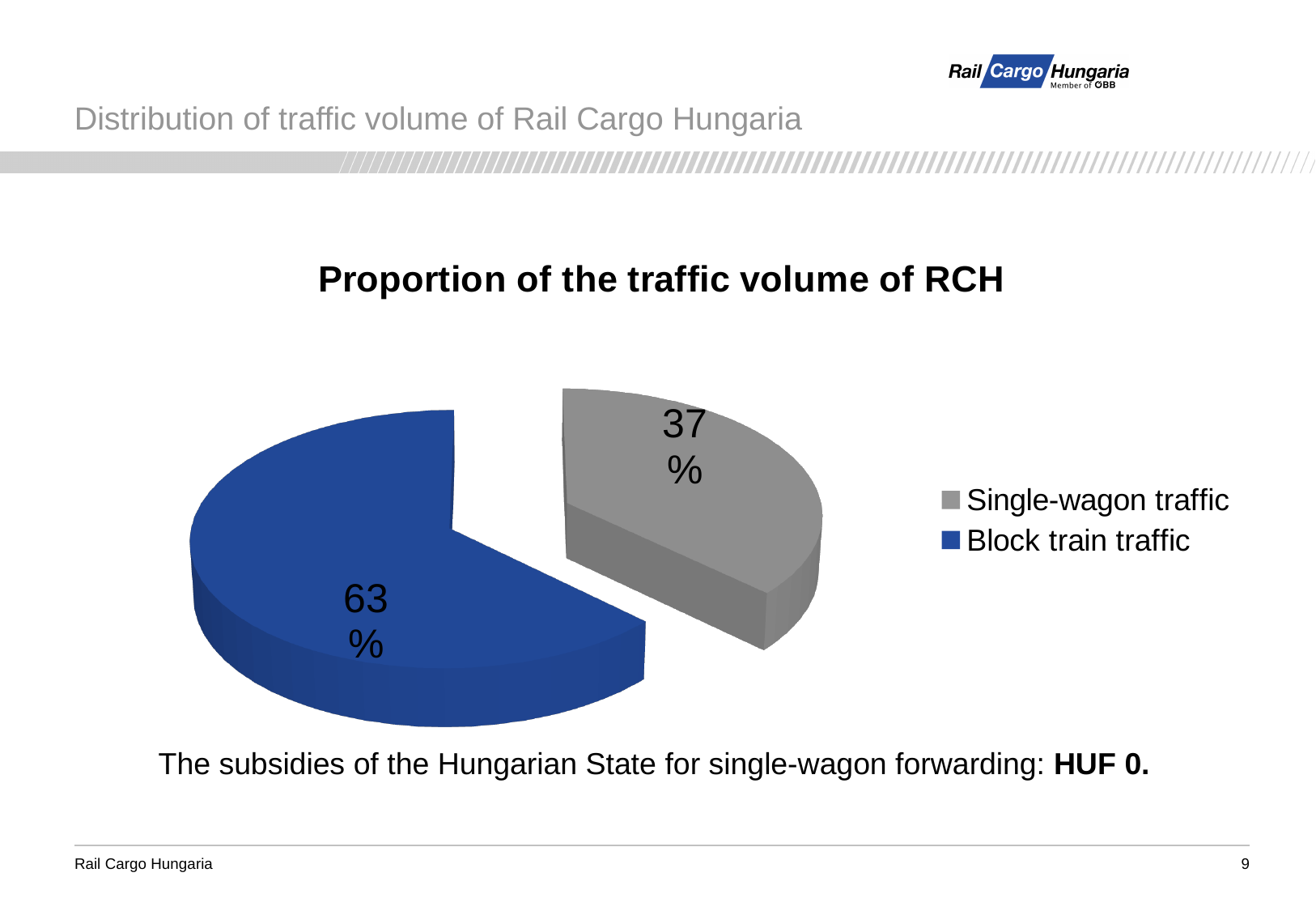
What type of chart is shown on the slide? pie chart How many slices does the pie chart have? 2 Which is larger, Single-wagon traffic or Block train traffic? Block train traffic What share of the traffic volume is Single-wagon traffic? 37% How many entries does the legend list? 2 How many percentage points larger is Block train traffic than Single-wagon traffic? 26 What share of the traffic volume is Block train traffic? 63% Which category has the smallest share of the pie? Single-wagon traffic What colour is the Block train traffic slice? blue Is the share for Single-wagon traffic greater or less than 50%? less Which category has the largest share of the pie? Block train traffic What is the chart's title? Proportion of the traffic volume of RCH